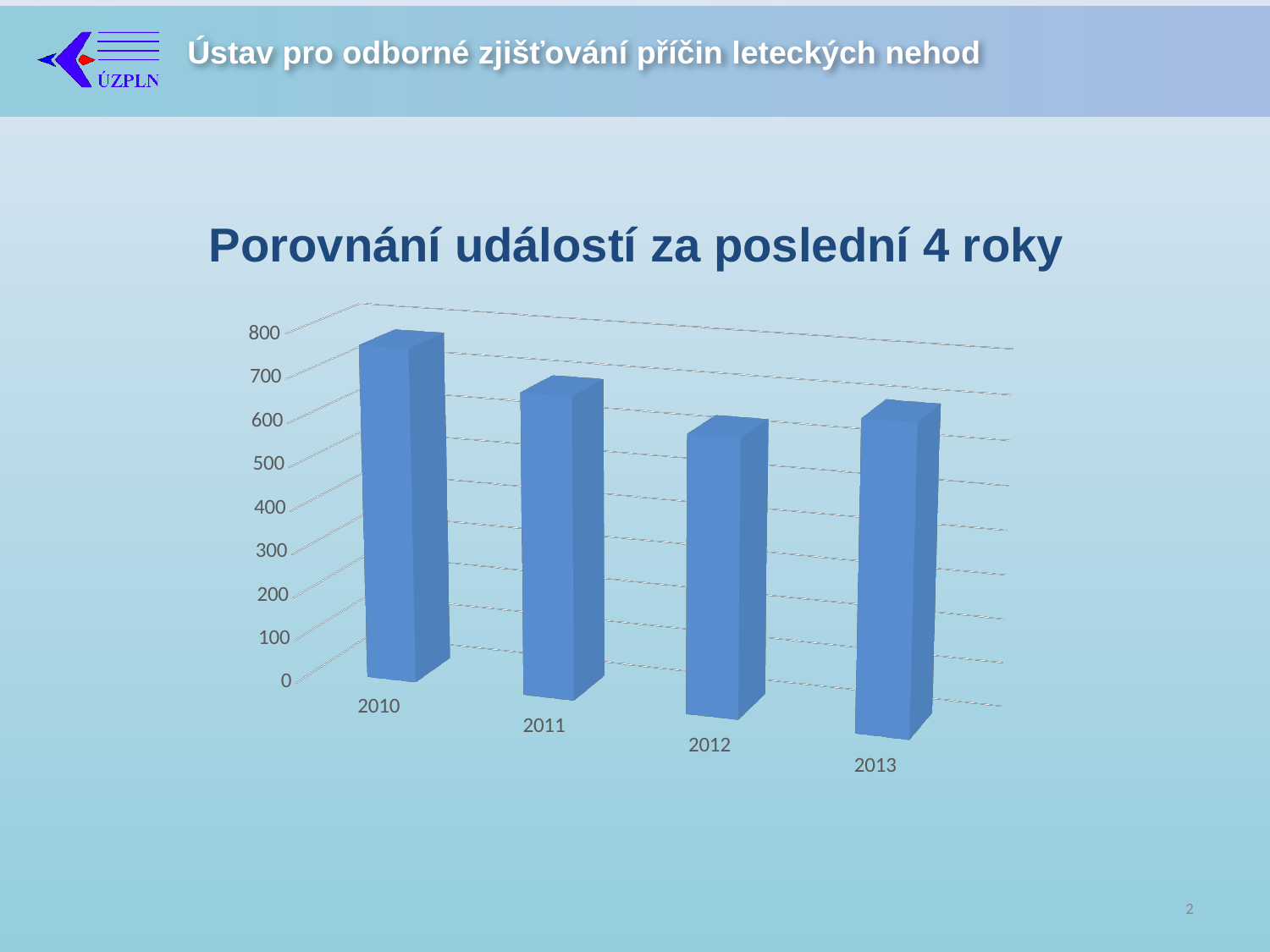
Which year has the larger value, 2012 or 2013? 2013 Is the value for 2011 greater or less than 600? greater Which year has the highest bar in the chart? 2010 What is the title of the chart? Porovnání událostí za poslední 4 roky How many years (categories) are shown on the x axis of the chart? 4 Is the value for 2012 greater or less than 700? less Which year has the lowest bar in the chart? 2012 Which year has the larger value, 2010 or 2011? 2010 Do the values rise or fall from 2010 to 2012? fall Is the value for 2010 greater or less than 700? greater What kind of chart is shown on the slide? bar chart